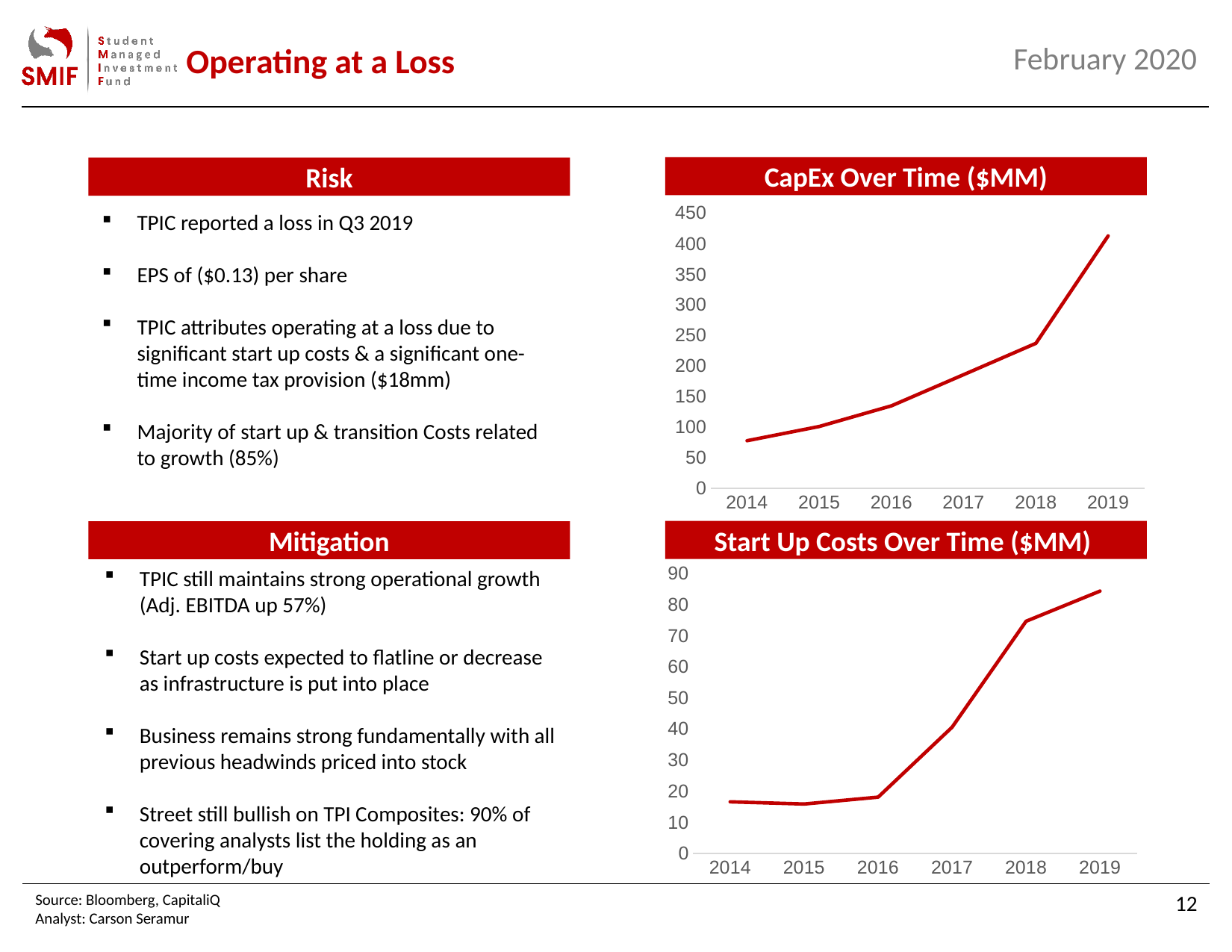
In the 'Start Up Costs Over Time ($MM)' chart, which year has the highest start up costs? 2019 In the 'CapEx Over Time ($MM)' chart, how many years are shown on the x axis? 6 In the 'CapEx Over Time ($MM)' chart, is the value for 2018 greater or less than 250? less What kind of chart is the 'Start Up Costs Over Time ($MM)' chart? line chart In the 'CapEx Over Time ($MM)' chart, which year has the highest CapEx? 2019 In the 'CapEx Over Time ($MM)' chart, is the value for 2014 greater or less than 100? less What kind of chart is the 'CapEx Over Time ($MM)' chart? line chart In the 'Start Up Costs Over Time ($MM)' chart, is the value for 2014 greater or less than 20? less In the 'CapEx Over Time ($MM)' chart, do values rise or fall from 2014 to 2019? rise In the 'CapEx Over Time ($MM)' chart, which year has the lowest CapEx? 2014 In the 'Start Up Costs Over Time ($MM)' chart, how many years are shown on the x axis? 6